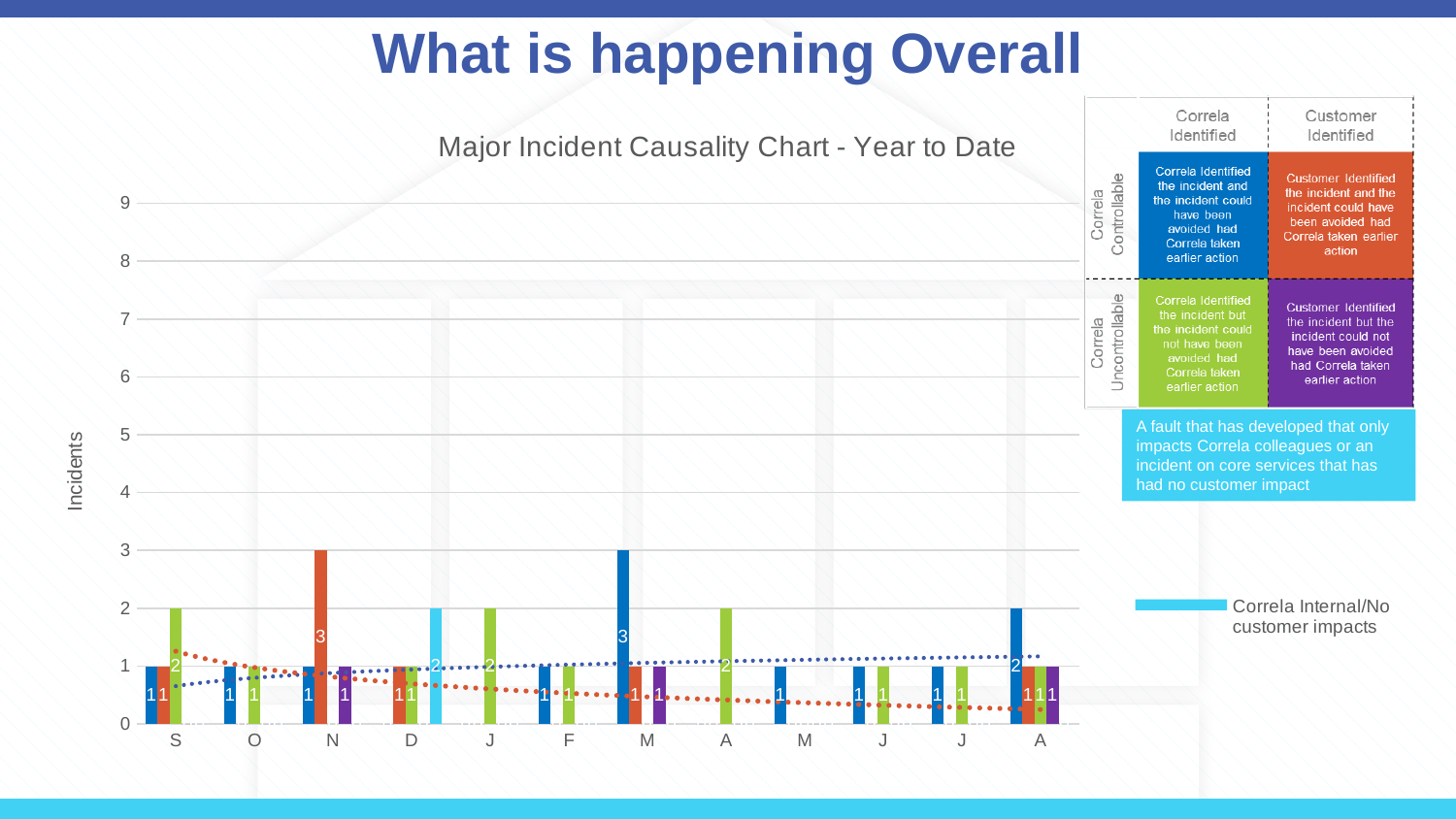
What is the value of the dark blue bar for the last month, labelled A? 2 How many months are shown on the x axis of the Major Incident Causality Chart? 12 What is the difference between the orange bar and the dark blue bar for the month labelled N? 2 What is the value of the light blue bar for the month labelled D? 2 Does the orange dotted trend line rise or fall from left to right across the months? fall What is the value of the orange bar for the month labelled N? 3 For the month labelled S, which is larger: the green bar or the dark blue bar? green bar What is the value of the dark blue bar for the month labelled M (the first M, after F)? 3 What is the value of the green bar for the month labelled S? 2 What is the highest value reached by any bar in the chart? 3 What type of chart is the Major Incident Causality Chart? bar chart What label is given to the light blue series in the legend? Correla Internal/No customer impacts